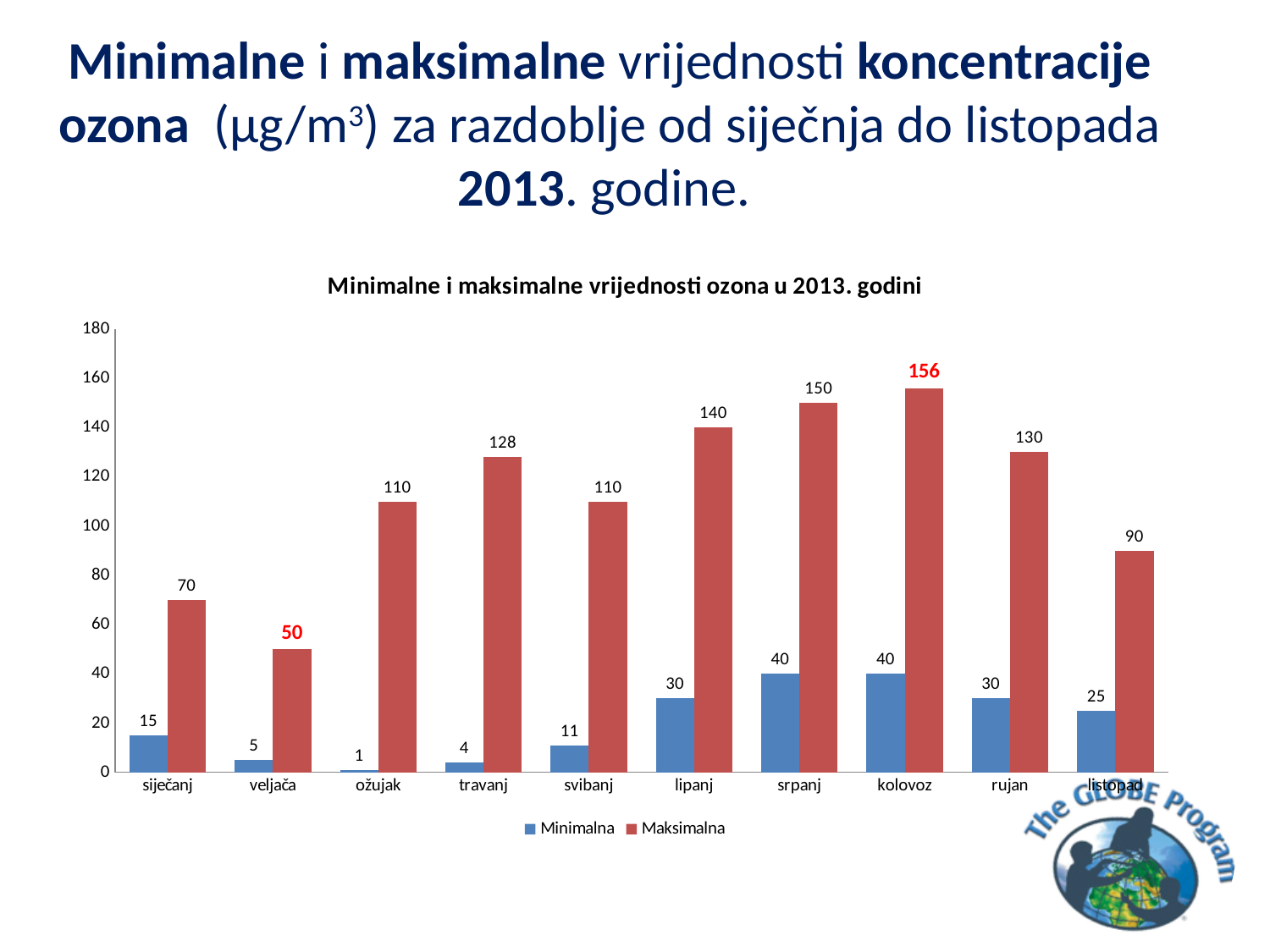
What is the Minimalna value for svibanj? 11 How many series does the legend list? 2 Is the Maksimalna value for lipanj greater or less than 120? greater What kind of chart is shown on the slide? bar chart Which month has the lowest Minimalna value? ožujak What is the difference between the Maksimalna and Minimalna values for srpanj? 110 What is the title of the chart? Minimalne i maksimalne vrijednosti ozona u 2013. godini Which is larger, the Maksimalna value for rujan or the Maksimalna value for listopad? rujan What is the Maksimalna value for travanj? 128 How many months are shown on the x axis? 10 What is the Maksimalna value for kolovoz? 156 Which month has the highest Maksimalna value? kolovoz